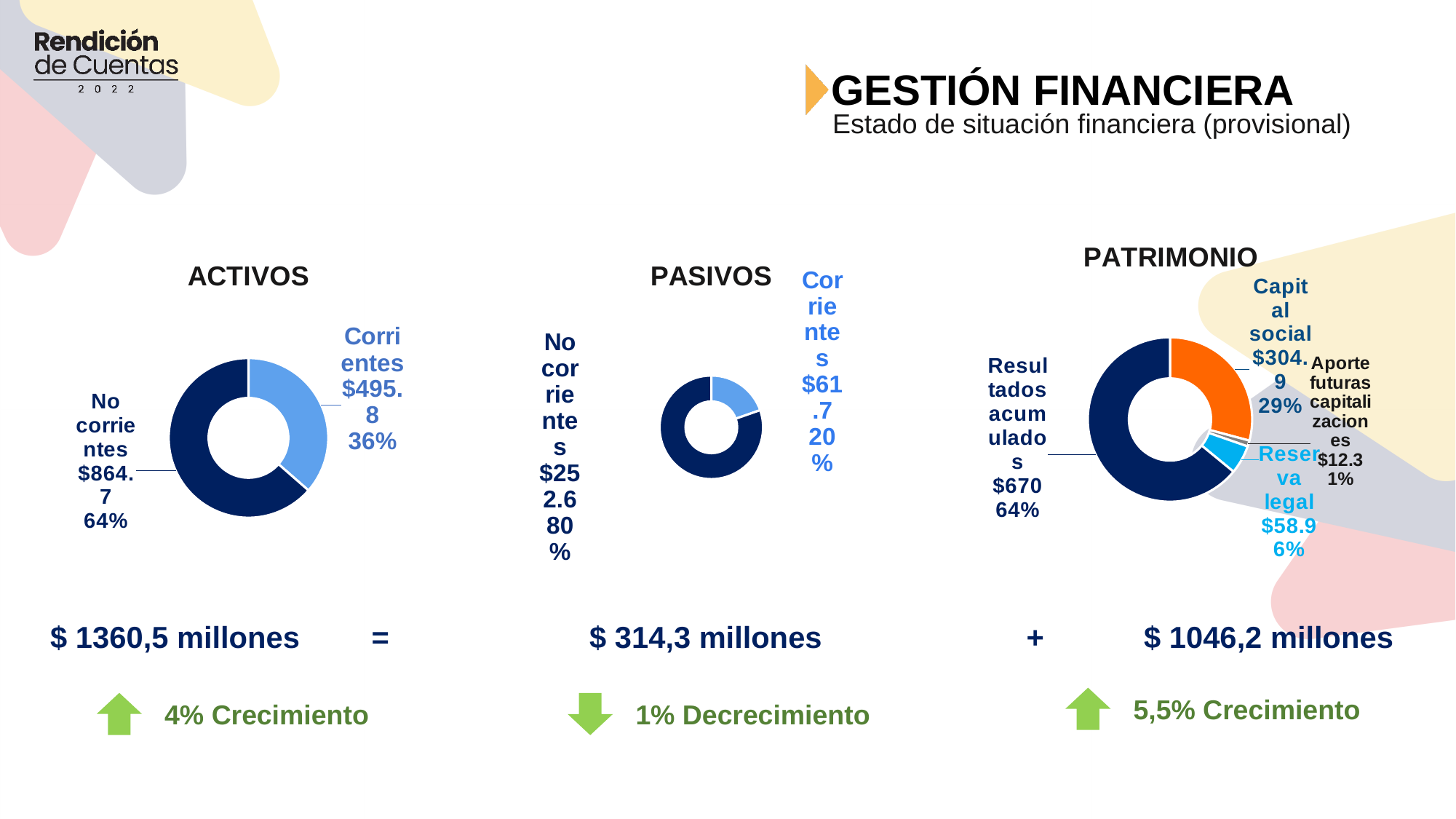
In the PASIVOS chart, what is the difference between No corrientes ($252.6) and Corrientes ($61.7)? $190.9 What kind of chart is used for ACTIVOS? Donut (pie) chart In the ACTIVOS chart, what share of the total is No corrientes? 64% In the PASIVOS chart, what share of the total is No corrientes? 80% In the PATRIMONIO chart, which category has the smallest share? Aporte futuras capitalizaciones In the PATRIMONIO chart, what share of the total is Capital social? 29% In the ACTIVOS chart, what value is shown for Corrientes? $495.8 In the PATRIMONIO chart, which category has the largest share? Resultados acumulados In the PASIVOS chart, what value is shown for Corrientes? $61.7 In the ACTIVOS chart, which slice is larger, Corrientes or No corrientes? No corrientes In the PATRIMONIO chart, what value is shown for Reserva legal? $58.9 How many slices does the PATRIMONIO chart have? 4